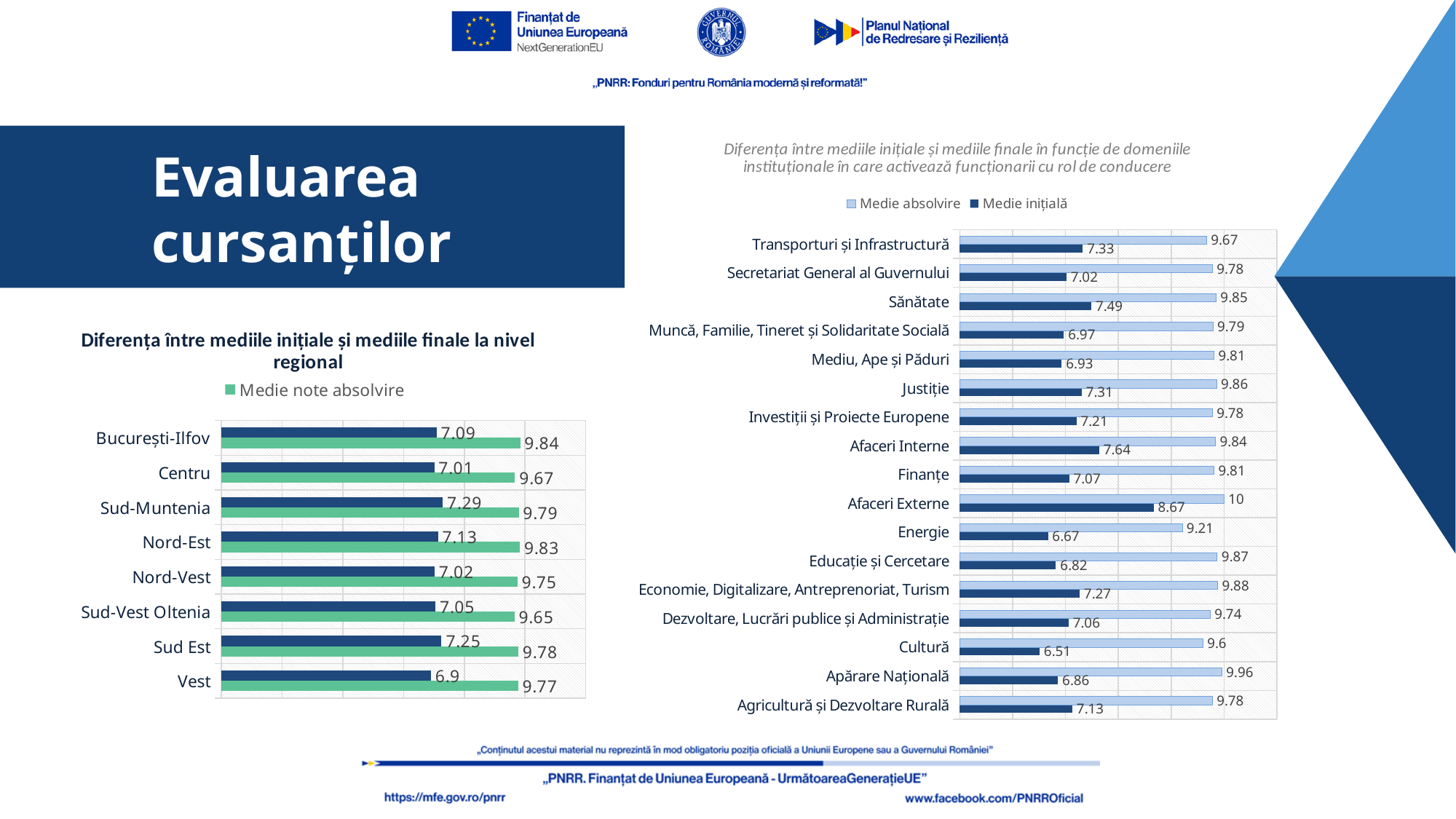
How many series does the legend of the chart on the right list? 2 In the regional chart on the left, what is the dark blue (initial average) value for Vest? 6.9 In the regional chart on the left, what is the difference between the final and initial averages for Sud-Muntenia? 2.5 In the regional chart on the left, what is the Medie note absolvire value for Nord-Est? 9.83 In the chart on the right by institutional domain, which domain has the lowest Medie inițială? Cultură In the chart on the right by institutional domain, what is the Medie absolvire value for Energie? 9.21 How many regions are shown in the regional chart on the left? 8 In the regional chart on the left, which region has the lowest Medie note absolvire? Sud-Vest Oltenia In the chart on the right by institutional domain, is the Medie inițială larger for Sănătate or for Justiție? Sănătate In the chart on the right by institutional domain, which domain has the highest Medie absolvire? Afaceri Externe In the regional chart on the left, which region has the highest Medie note absolvire? București-Ilfov In the chart on the right by institutional domain, what is the Medie inițială value for Afaceri Externe? 8.67